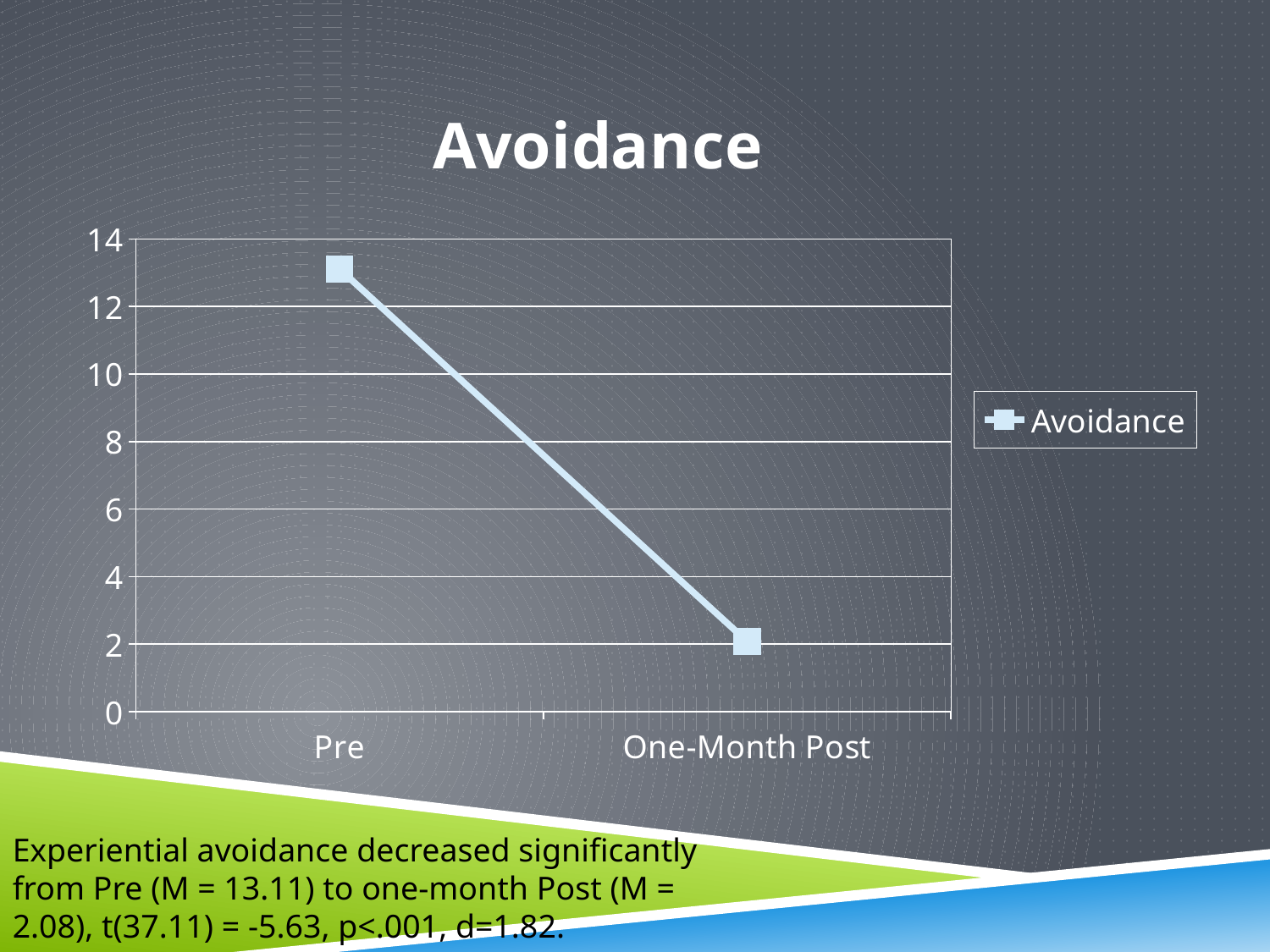
Which category has the higher Avoidance value, Pre or One-Month Post? Pre What kind of chart is shown on the slide? line chart Which category has the highest Avoidance value? Pre Is the Avoidance value for Pre greater or less than 12? greater How many series does the legend list? 1 Which category has the lowest Avoidance value? One-Month Post Do the Avoidance values rise or fall from Pre to One-Month Post? fall How many categories are shown on the x axis? 2 Is the Avoidance value for One-Month Post greater or less than 4? less According to the text on the slide, what is the mean Avoidance value at One-Month Post? 2.08 According to the text on the slide, what is the mean Avoidance value at Pre? 13.11 What is the title of the chart? Avoidance